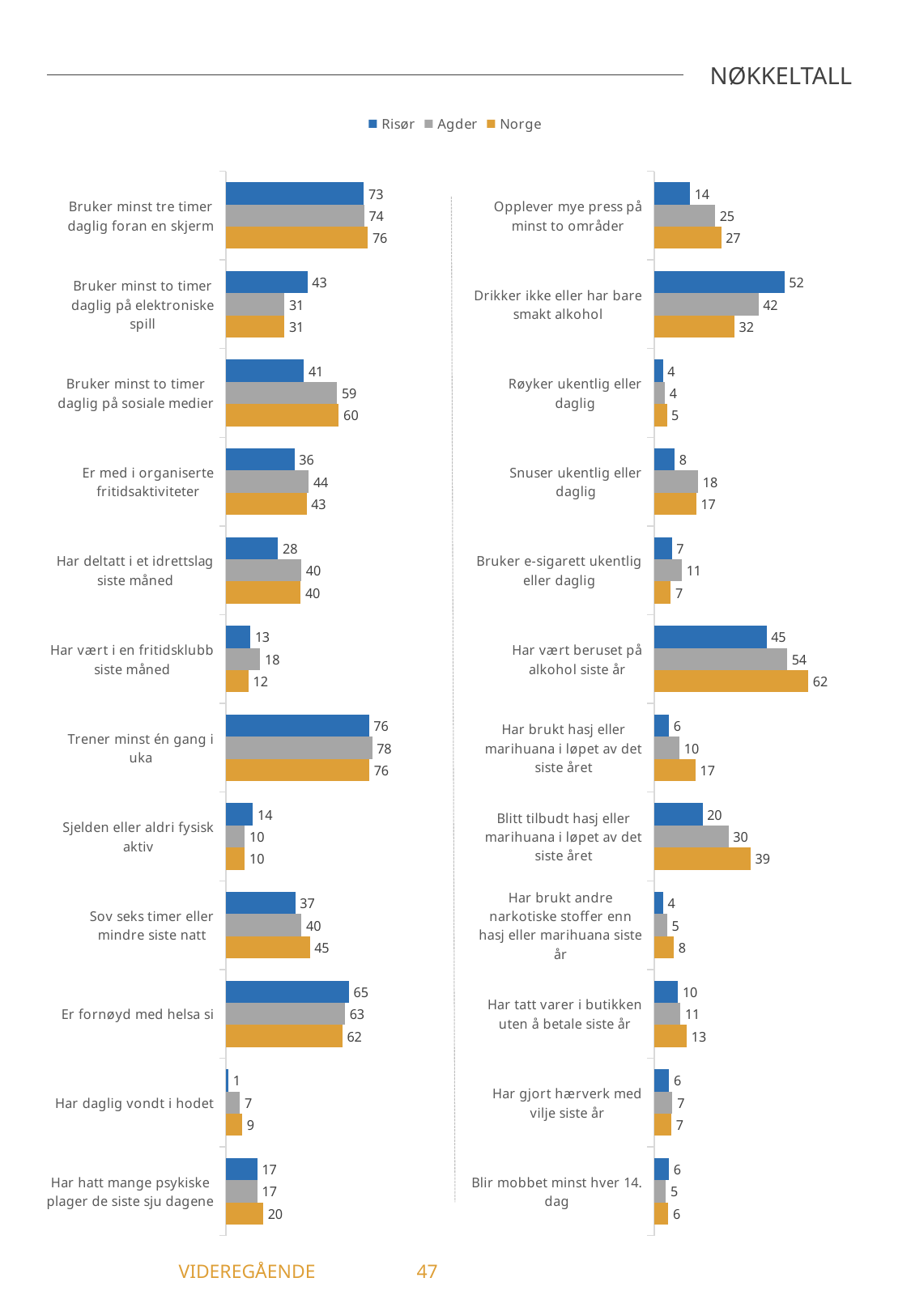
What kind of chart is used on this slide? Bar chart In the right chart, what is the difference between the Norge and Risør values for "Blitt tilbudt hasj eller marihuana i løpet av det siste året"? 19 In the left chart, which is larger for "Bruker minst to timer daglig på sosiale medier": the Risør value or the Agder value? Agder In the right chart, which series has the highest value for "Drikker ikke eller har bare smakt alkohol"? Risør How many categories are shown in the right chart? 12 Which series is shown in orange in the legend? Norge In the left chart, which category has the highest Risør value? Trener minst én gang i uka In the right chart, what is the Norge value for "Har vært beruset på alkohol siste år"? 62 In the left chart, what is the Agder value for "Har vært i en fritidsklubb siste måned"? 18 In the left chart, what is the Risør value for "Bruker minst to timer daglig på elektroniske spill"? 43 In the left chart, which category has the lowest Risør value? Har daglig vondt i hodet How many series does the legend list? 3